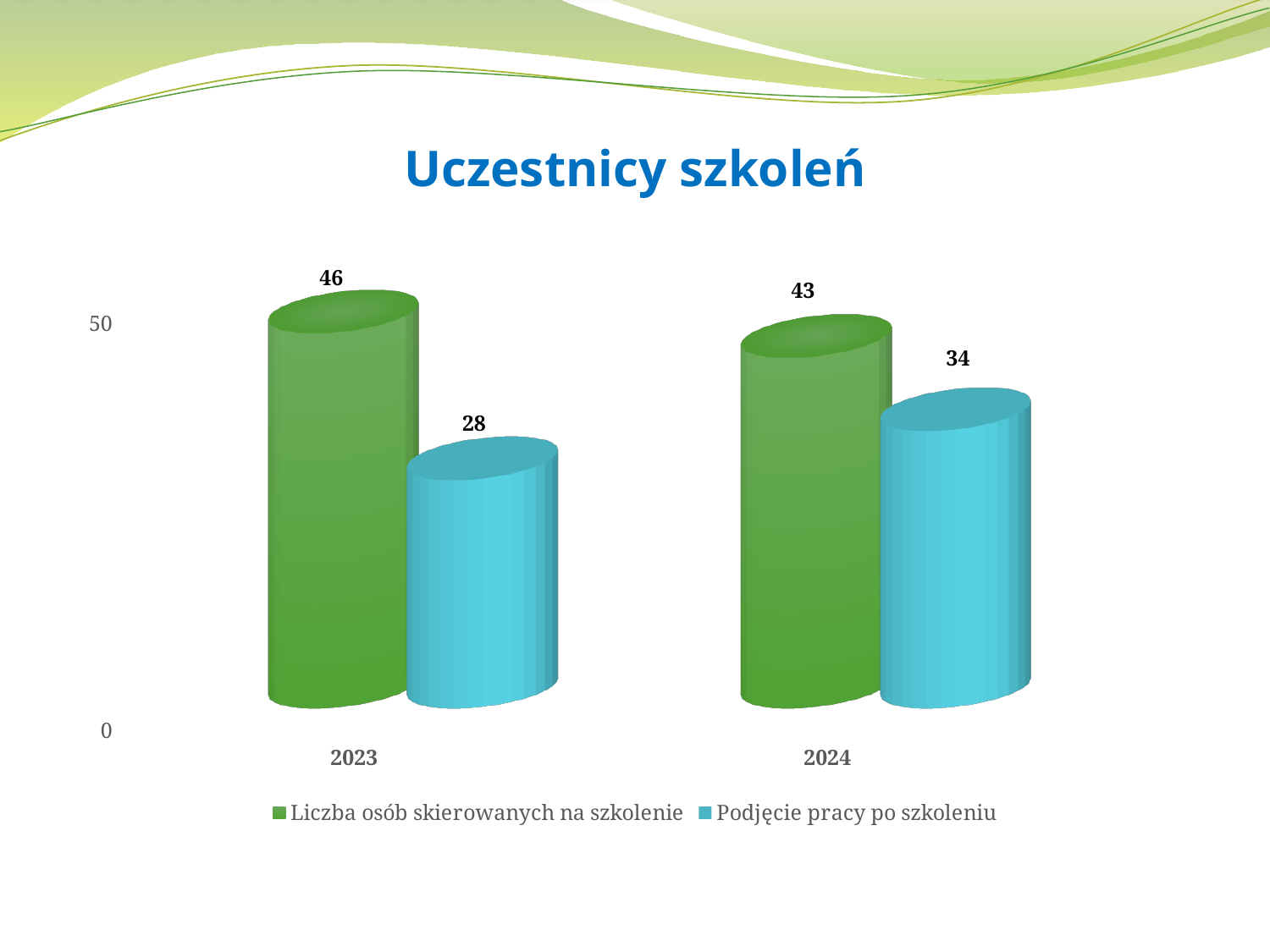
What is the value of 'Podjęcie pracy po szkoleniu' for 2023? 28 What is the difference between 'Liczba osób skierowanych na szkolenie' and 'Podjęcie pracy po szkoleniu' in 2023? 18 What is the difference between 'Liczba osób skierowanych na szkolenie' and 'Podjęcie pracy po szkoleniu' in 2024? 9 What is the value of 'Liczba osób skierowanych na szkolenie' for 2024? 43 What is the title of the chart? Uczestnicy szkoleń What is the value of 'Podjęcie pracy po szkoleniu' for 2024? 34 How many series does the legend list? 2 Which year has the highest value for 'Liczba osób skierowanych na szkolenie'? 2023 What is the value of 'Liczba osób skierowanych na szkolenie' for 2023? 46 Which year has the lowest value for 'Podjęcie pracy po szkoleniu'? 2023 Which is larger: 'Podjęcie pracy po szkoleniu' in 2023 or in 2024? 2024 What kind of chart is shown on the slide? Bar chart